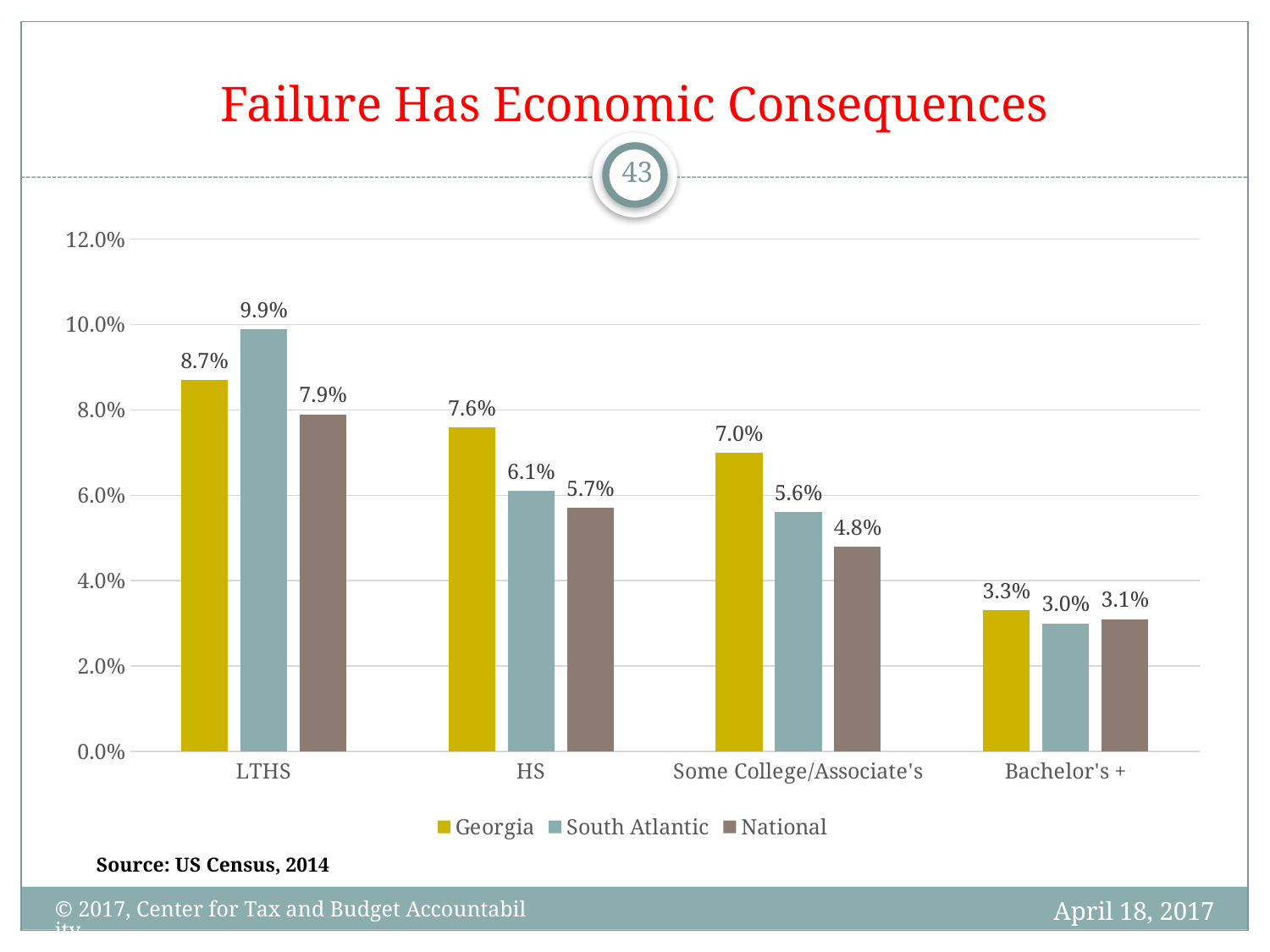
What is the value for South Atlantic in the HS category? 6.1% What is the value for Georgia in the LTHS category? 8.7% Which is larger, the Georgia value for HS or the Georgia value for Some College/Associate's? Georgia value for HS Do the Georgia values rise or fall from LTHS to Bachelor's +? Fall How many series does the legend list? 3 What is the difference between the South Atlantic and National values for LTHS? 2.0% What kind of chart is shown on the slide? Bar chart Which series has the highest value in the LTHS category? South Atlantic What is the difference between the Georgia and South Atlantic values for Some College/Associate's? 1.4% What is the National value for Some College/Associate's? 4.8% How many categories are shown on the x axis? 4 Which category has the lowest Georgia value? Bachelor's +